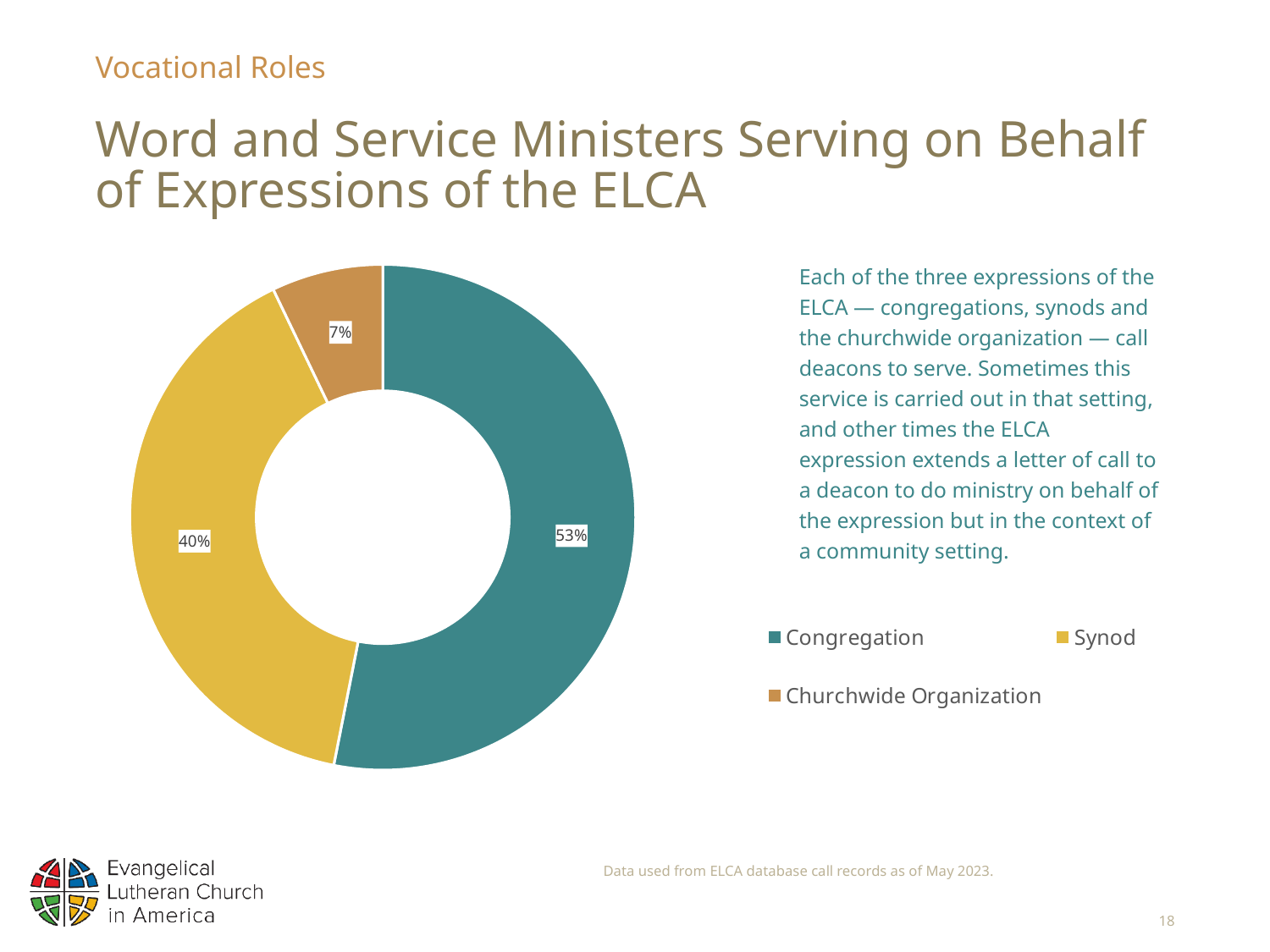
What colour represents Congregation in the chart? Teal How many categories are shown in the chart? 3 What share of Word and Service ministers serve on behalf of a Congregation? 53% What is the difference in percentage points between the Congregation share and the Synod share? 13 Which expression of the ELCA has the largest share of Word and Service ministers? Congregation What share of Word and Service ministers serve on behalf of a Synod? 40% Which is larger, the share for Synod or the share for Churchwide Organization? Synod What share of Word and Service ministers serve on behalf of the Churchwide Organization? 7% Which expression of the ELCA has the smallest share of Word and Service ministers? Churchwide Organization What colour represents Synod in the chart? Yellow What kind of chart is shown on the slide? Pie chart (doughnut) What is the difference in percentage points between the Synod share and the Churchwide Organization share? 33